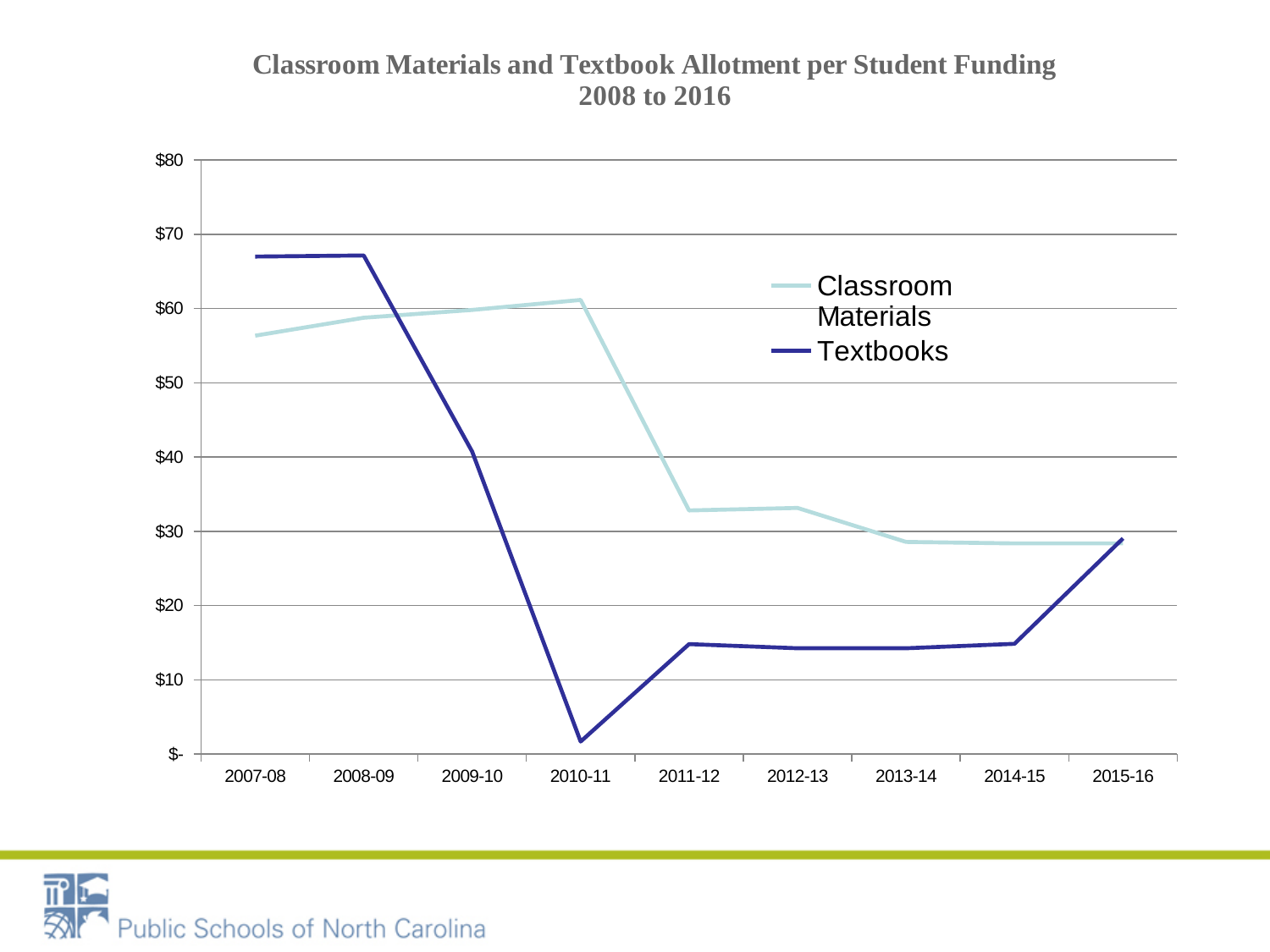
Does the Textbooks line rise or fall between 2008-09 and 2010-11? fall In which school year is the Textbooks value highest? 2008-09 How many school years are shown along the x axis? 9 In which school year is the Textbooks value lowest? 2010-11 Which series has the larger value in 2009-10, Classroom Materials or Textbooks? Classroom Materials How many series does the legend list? 2 Is the Classroom Materials value for 2010-11 greater or less than $60? greater What is the title of the chart? Classroom Materials and Textbook Allotment per Student Funding 2008 to 2016 Which series has the larger value in 2007-08, Classroom Materials or Textbooks? Textbooks Is the Textbooks value for 2007-08 greater or less than $60? greater Is the Textbooks value for 2010-11 greater or less than $10? less What kind of chart is shown on the slide? line chart